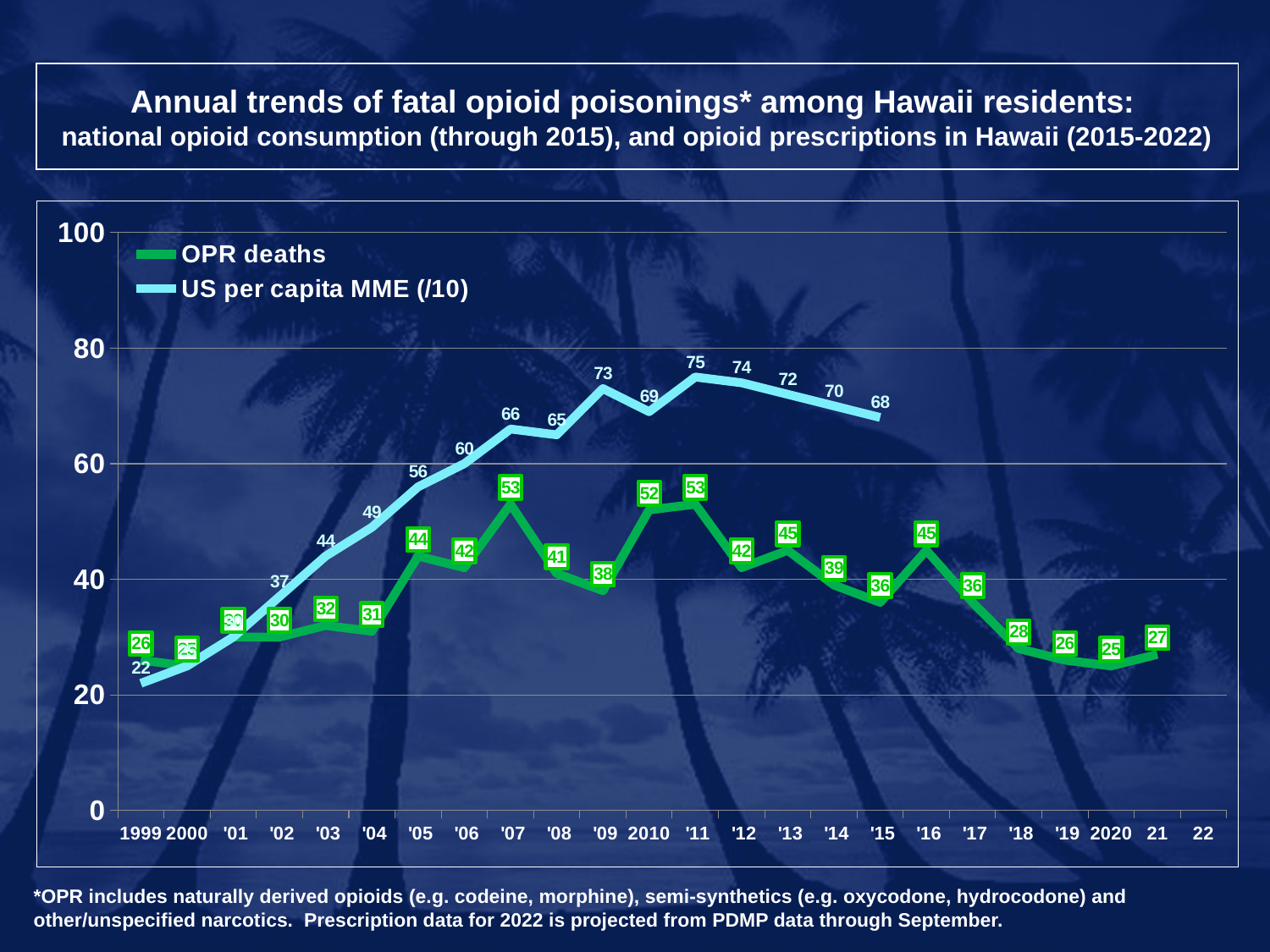
What is the value of OPR deaths in 2021? 27 What is the difference between OPR deaths in 2016 and 2017? 9 Which year had more OPR deaths, 2013 or 2014? 2013 What is the US per capita MME (/10) value in 2011? 75 By how much did the US per capita MME (/10) value fall from 2011 to 2015? 7 What is the value of OPR deaths in 2007? 53 How many series does the legend list? 2 Is the value for OPR deaths in 2018 greater or less than 40? less What kind of chart is shown on the slide? line chart In which year is the US per capita MME (/10) value lowest? 1999 What is the highest value reached by the OPR deaths series? 53 In which year does the US per capita MME (/10) series reach its highest value? '11